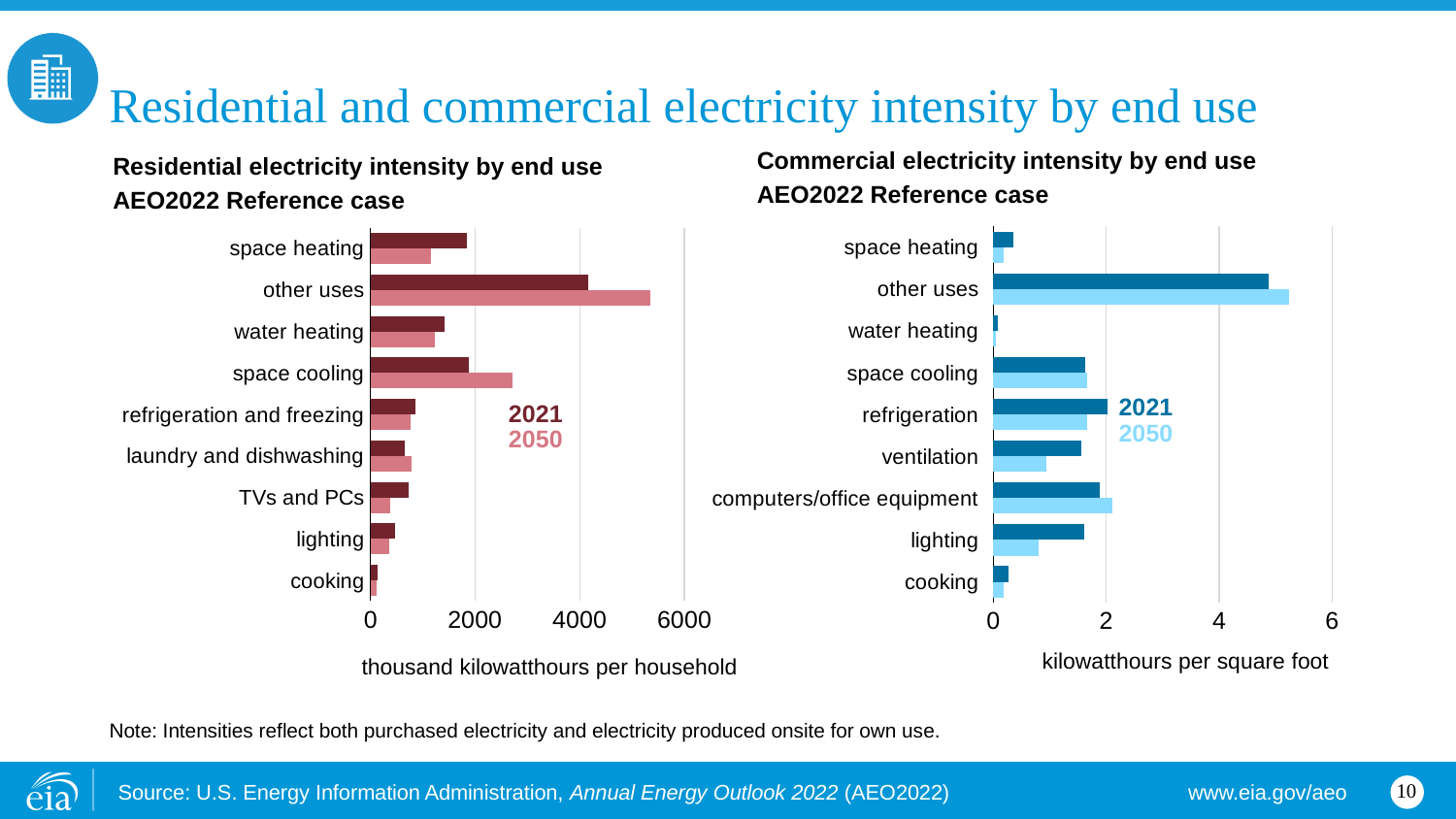
In the Commercial electricity intensity by end use chart, which end use has the lowest 2021 value? water heating What is the x-axis unit of the Commercial electricity intensity by end use chart? kilowatthours per square foot In the Residential electricity intensity by end use chart, which end use has the lowest 2021 value? cooking In the Residential electricity intensity by end use chart, is the 2021 value for space cooling larger or smaller than the 2050 value? smaller How many series does the legend list in the Commercial electricity intensity by end use chart? 2 What type of chart is the Residential electricity intensity by end use chart? bar chart In the Residential electricity intensity by end use chart, is the 2050 value for other uses greater or less than 4000? greater How many end-use categories are shown in the Residential electricity intensity by end use chart? 9 In the Residential electricity intensity by end use chart, which end use has the highest 2021 value? other uses In the Commercial electricity intensity by end use chart, which end use has the highest 2050 value? other uses In the Residential electricity intensity by end use chart, is the 2050 value for space cooling greater or less than 2000? greater In the Commercial electricity intensity by end use chart, is the 2021 value for lighting greater or less than 2? less